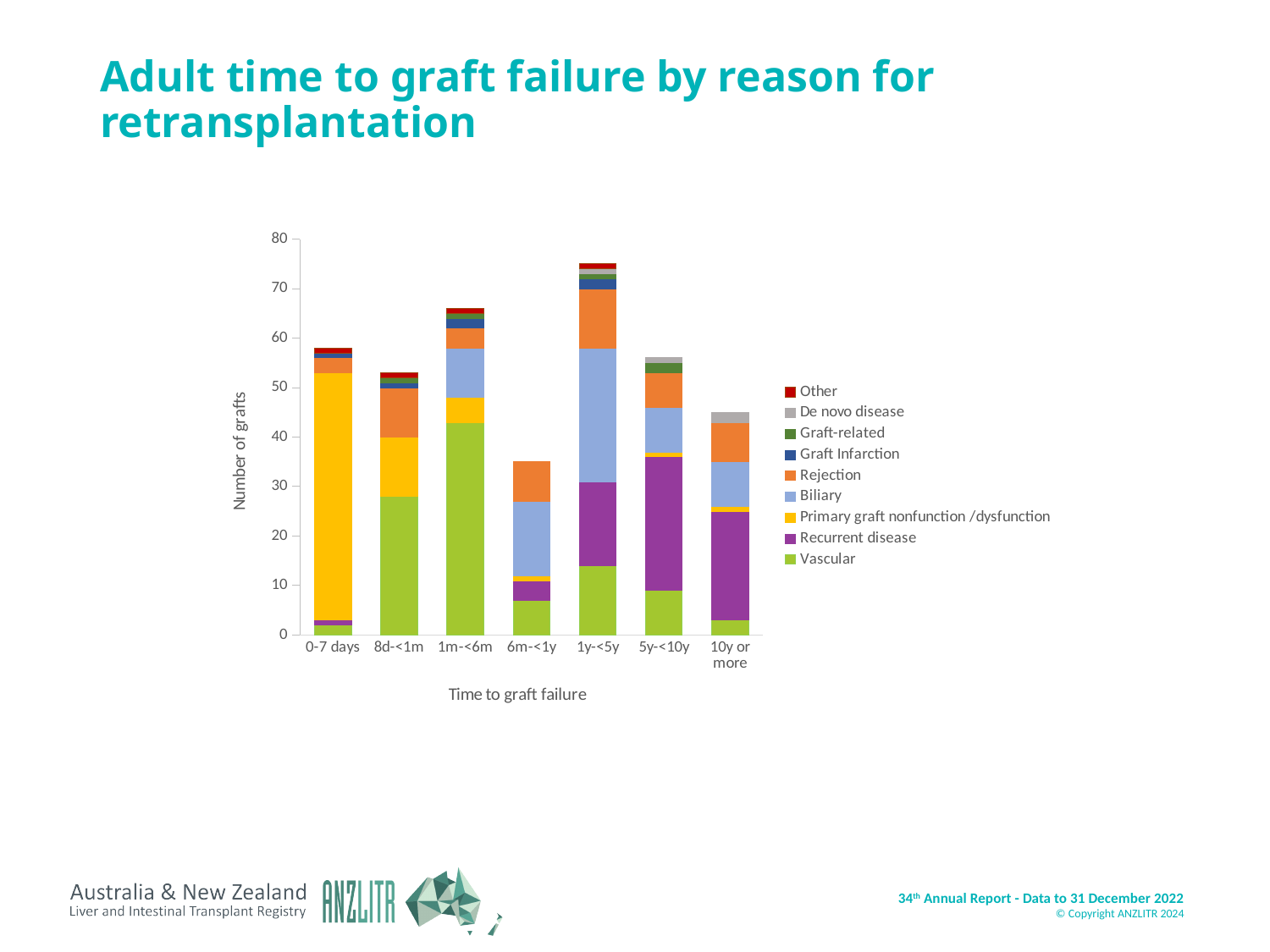
Which time-to-graft-failure category has the shortest stacked bar (lowest total number of grafts)? 6m-<1y Is the total number of grafts for 6m-<1y greater or less than 40? less Is the total number of grafts for 10y or more greater or less than 50? less Is the total number of grafts for 1m-<6m greater or less than 60? greater How many series does the legend list? 9 What is the label of the y axis? Number of grafts What kind of chart is shown on the slide? Stacked bar chart How many time-to-graft-failure categories are shown on the x axis? 7 Which time-to-graft-failure category has the tallest stacked bar (highest total number of grafts)? 1y-<5y Which has the larger total number of grafts, 10y or more or 6m-<1y? 10y or more Which has the larger total number of grafts, 1m-<6m or 8d-<1m? 1m-<6m